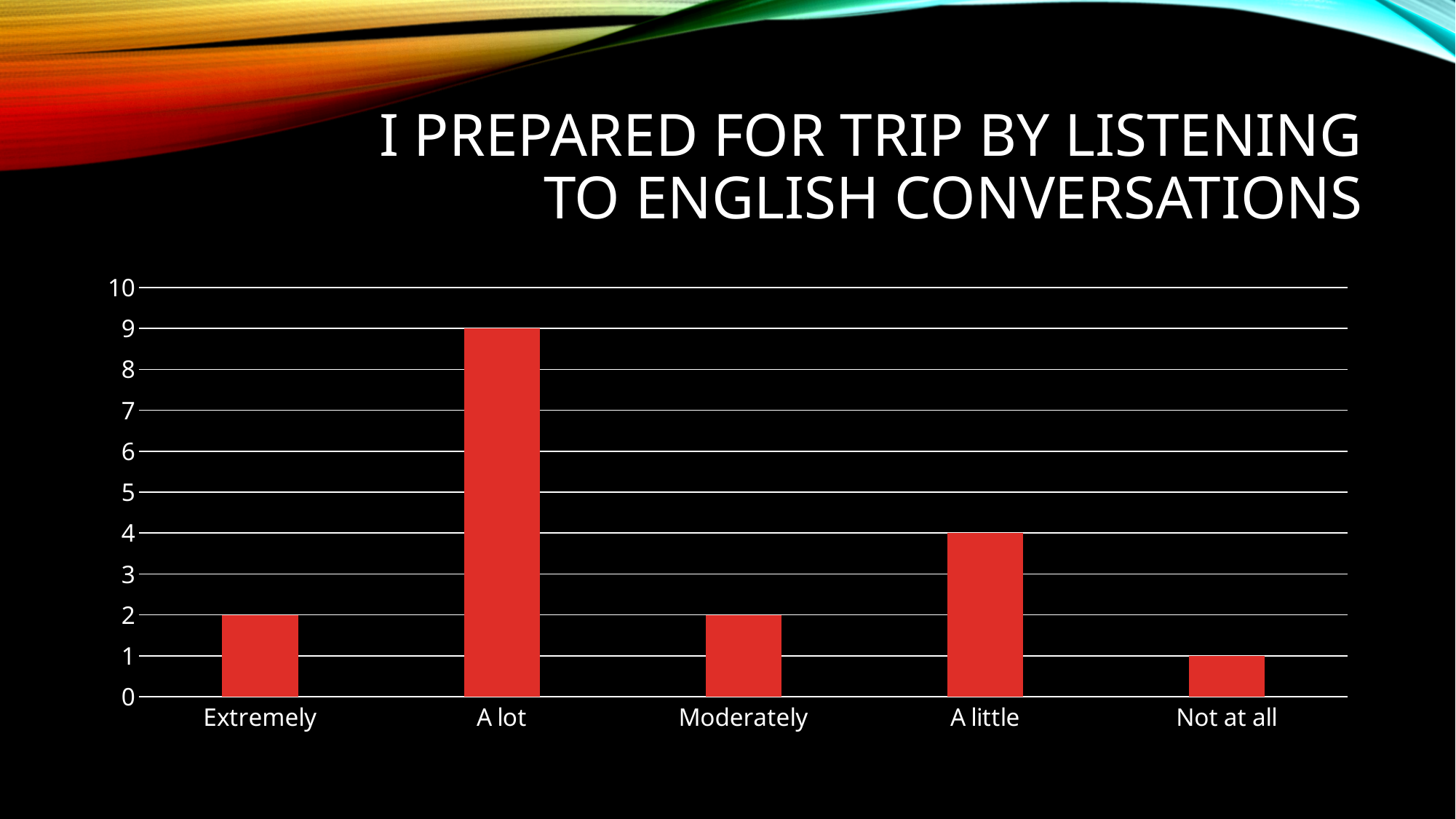
Which category has the highest value? A lot How many categories are shown on the x axis? 5 What is the value for "Not at all"? 1 What is the difference between the values for "A lot" and "A little"? 5 What kind of chart is shown on the slide? Bar chart Which is larger, the value for "A little" or the value for "Moderately"? A little What is the value for "A lot"? 9 Is the value for "A lot" greater or less than 5? greater What is the title of the slide containing the chart? I prepared for trip by listening to English conversations What is the value for "Extremely"? 2 Which category has the lowest value? Not at all What is the value for "A little"? 4